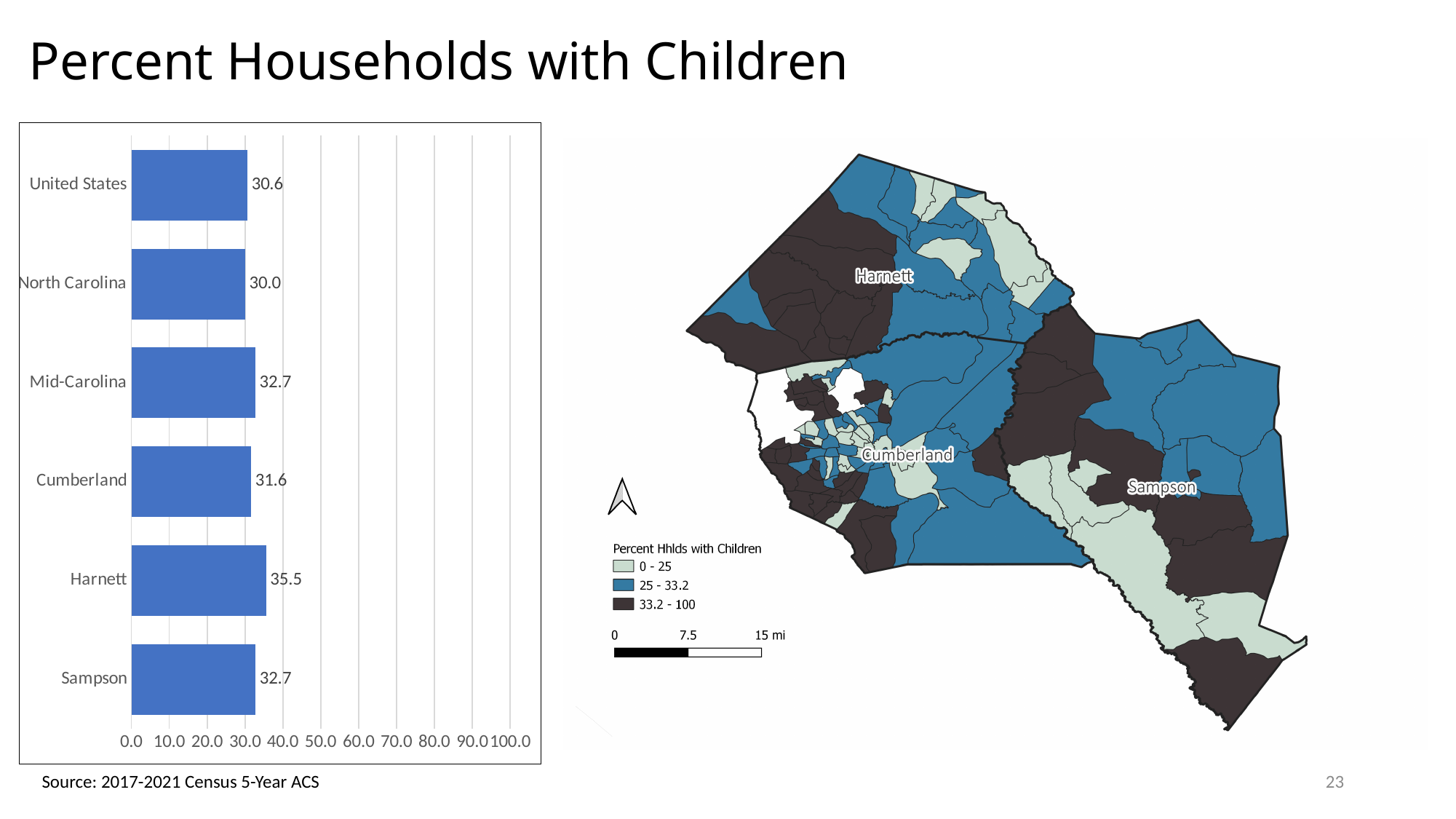
In the bar chart, what is the value for Harnett? 35.5 In the bar chart, which category has the highest value? Harnett In the bar chart, what is the value for United States? 30.6 How many categories are shown in the bar chart? 6 In the bar chart, what is the value for North Carolina? 30.0 What kind of chart is shown on the left of the slide? bar chart In the bar chart, which category has the lowest value? North Carolina In the bar chart, what is the difference between the values for Harnett and Cumberland? 3.9 In the bar chart, what is the difference between the values for Mid-Carolina and North Carolina? 2.7 In the bar chart, what is the value for Cumberland? 31.6 In the bar chart, which is larger, the value for Cumberland or the value for United States? Cumberland In the bar chart, is the value for Harnett greater or less than 40.0? less